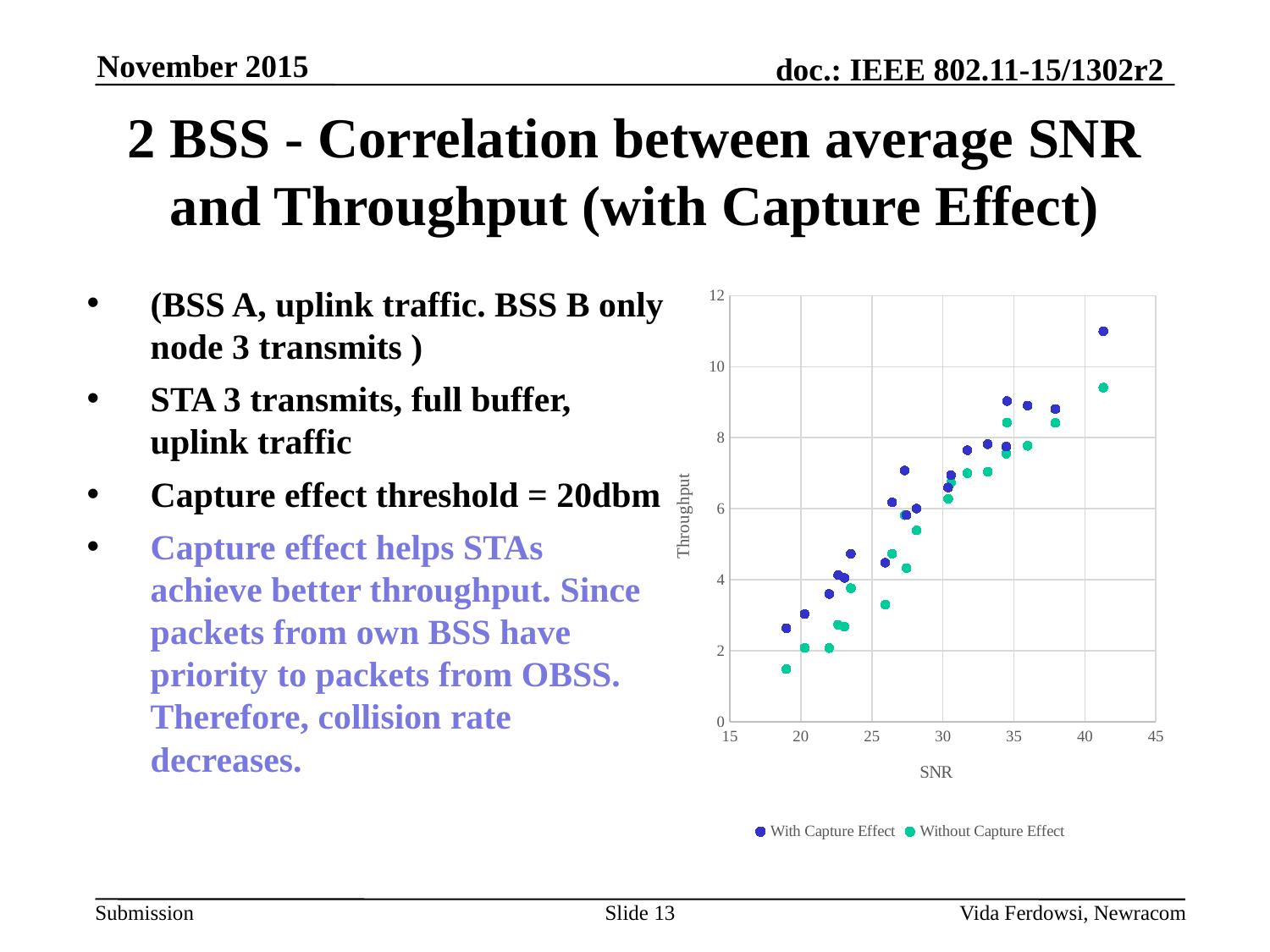
Which series reaches the highest throughput value on the chart? With Capture Effect Is the highest throughput value for the Without Capture Effect series greater or less than 10? less How many series does the chart legend list? 2 Is the lowest throughput value for the Without Capture Effect series greater or less than 2? less Is the lowest throughput value for the With Capture Effect series greater or less than 2? greater What kind of chart is shown on the slide? Scatter chart Which series contains the lowest throughput point on the chart? Without Capture Effect At the highest SNR plotted (around 41), which series has the higher throughput: With Capture Effect or Without Capture Effect? With Capture Effect As SNR increases along the x axis, does throughput generally rise or fall? Rise What are the two series named in the chart legend? With Capture Effect and Without Capture Effect What are the titles of the x axis and y axis of the chart? SNR (x axis) and Throughput (y axis)